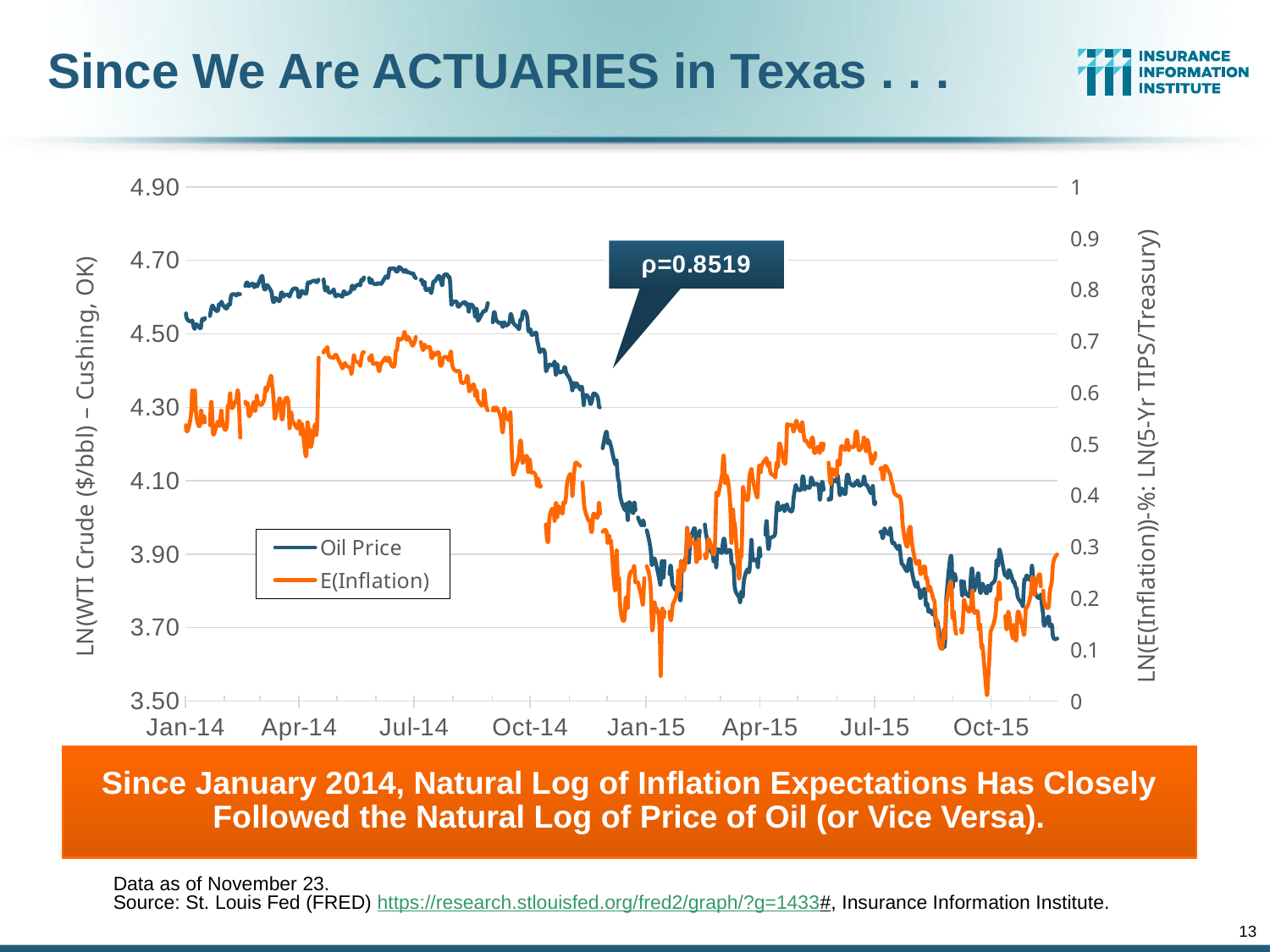
Is the Oil Price value at Jan-14 greater or less than 4.30 on the left axis? greater Is the E(Inflation) value at Jul-14 greater or less than 0.6 on the right axis? greater What kind of chart is shown on the slide? Line chart What are the two series named in the chart's legend? Oil Price and E(Inflation) Does the E(Inflation) series rise or fall between Jul-15 and Oct-15? Fall How many date labels are shown on the x axis? 8 What correlation value (ρ) is printed in the callout on the chart? ρ=0.8519 What is the highest value shown on the left vertical axis? 4.90 Does the Oil Price series rise or fall between Jul-14 and Jan-15? Fall Is the Oil Price value at Oct-15 greater or less than 4.10 on the left axis? less Which series is drawn in orange? E(Inflation) How many series does the chart's legend list? 2